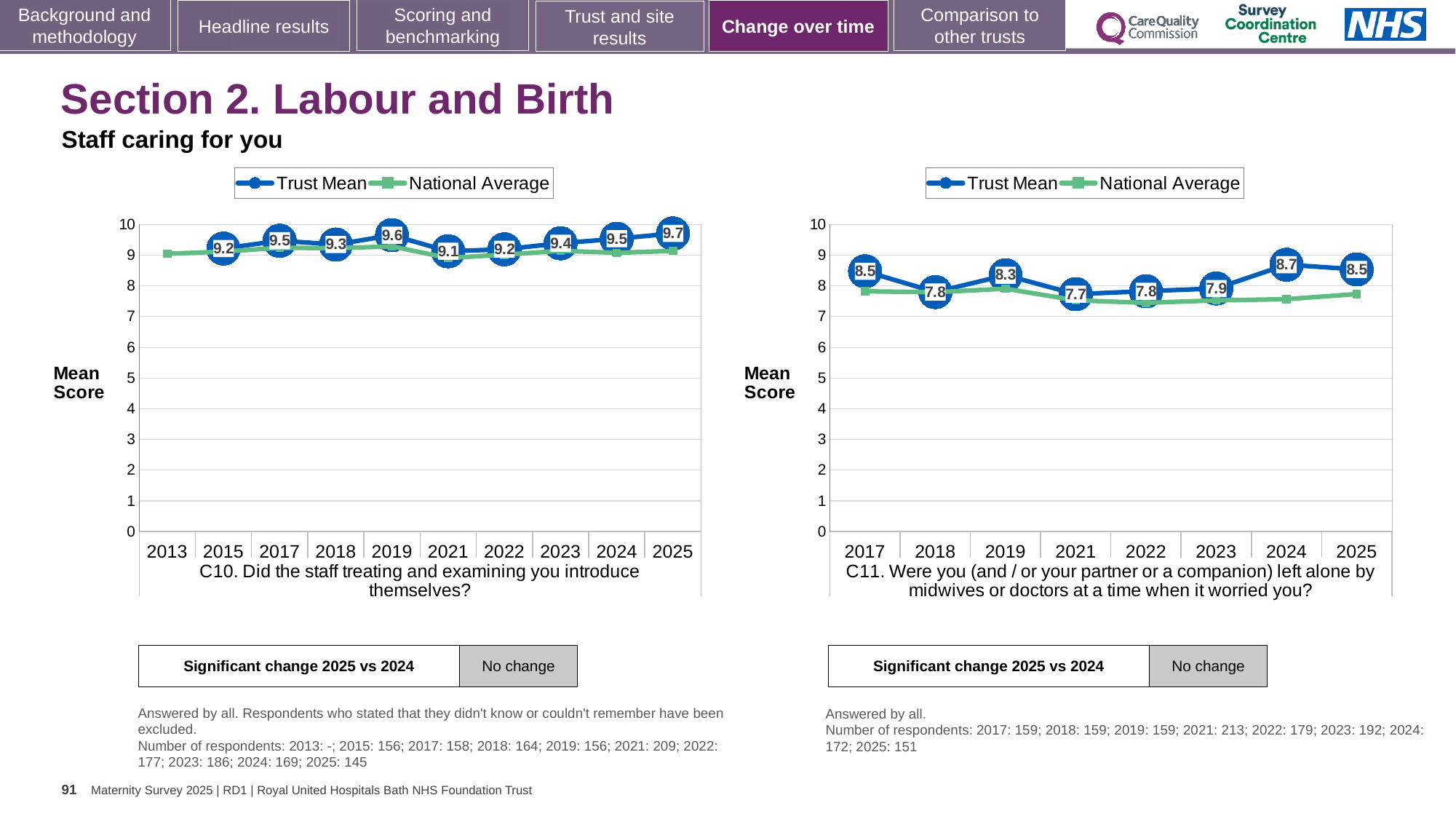
How many years are shown on the x axis of the C11 chart? 8 In the C11 chart, what is the Trust Mean score for 2024? 8.7 In the C11 chart, what is the difference between the Trust Mean scores for 2024 and 2021? 1.0 How many series does the legend of the C10 chart list? 2 In the C10 chart, is the Trust Mean score for 2019 larger than the Trust Mean score for 2021? Yes, 2019 (9.6) is larger than 2021 (9.1) In the C10 chart, what is the Trust Mean score for 2025? 9.7 In the C11 chart, is the National Average value for 2021 greater or less than 8? less In the C11 chart, did the Trust Mean score rise or fall from 2024 to 2025? Fall In the C10 chart, which year has the highest Trust Mean score? 2025 In the C10 chart, what is the Trust Mean score for 2021? 9.1 What kind of chart is the C10 chart? Line chart In the C11 chart, which year has the lowest Trust Mean score? 2021